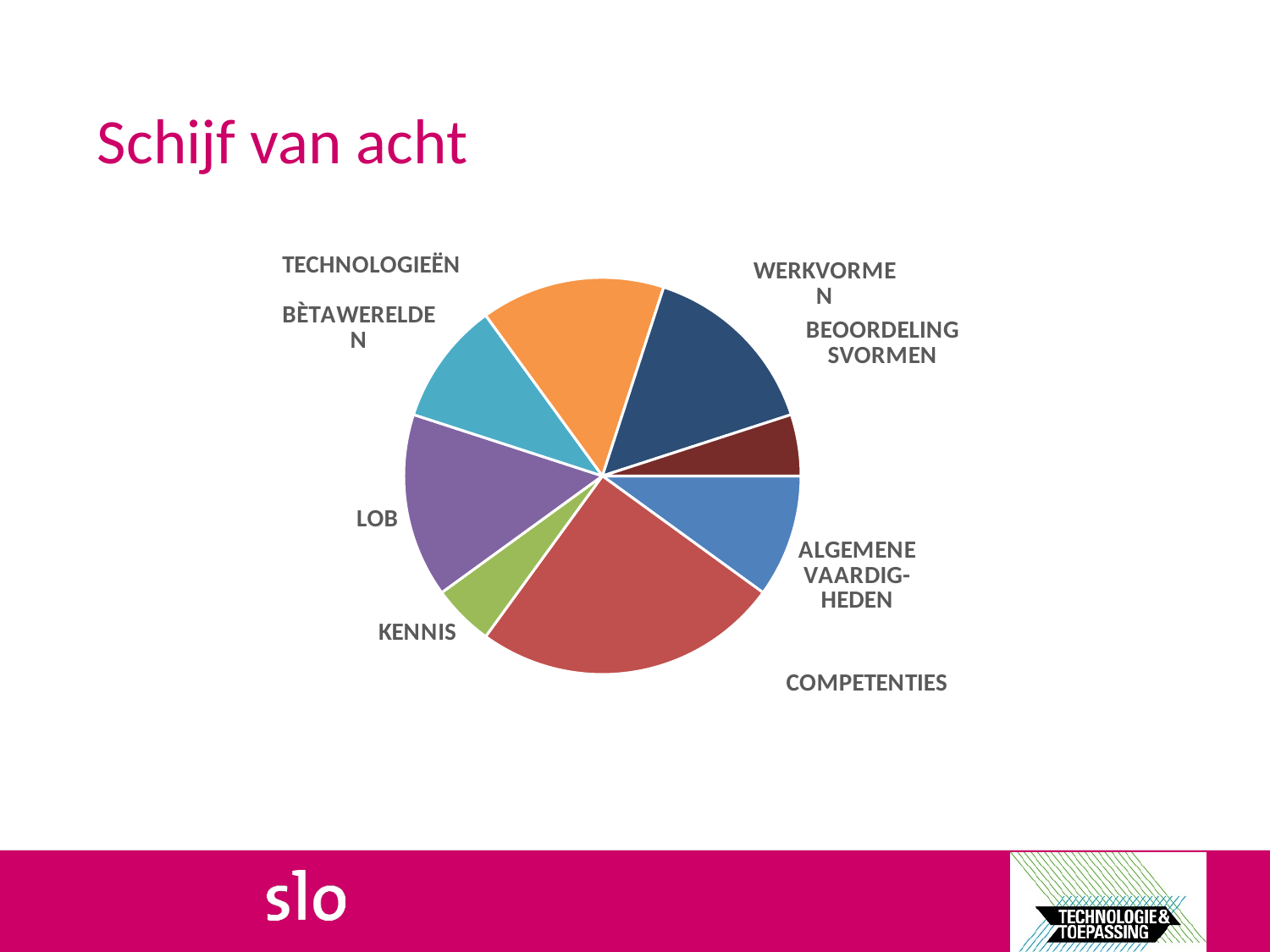
Which slice is larger, WERKVORMEN or KENNIS? WERKVORMEN Which slice is larger, COMPETENTIES or LOB? COMPETENTIES What is the title of the slide containing the pie chart? Schijf van acht Which slice is larger, LOB or BÈTAWERELDEN? LOB What colour is the COMPETENTIES slice of the pie chart? Red What kind of chart is shown on the slide? Pie chart How many slices does the pie chart have? 8 Which category has the largest slice of the pie chart? COMPETENTIES